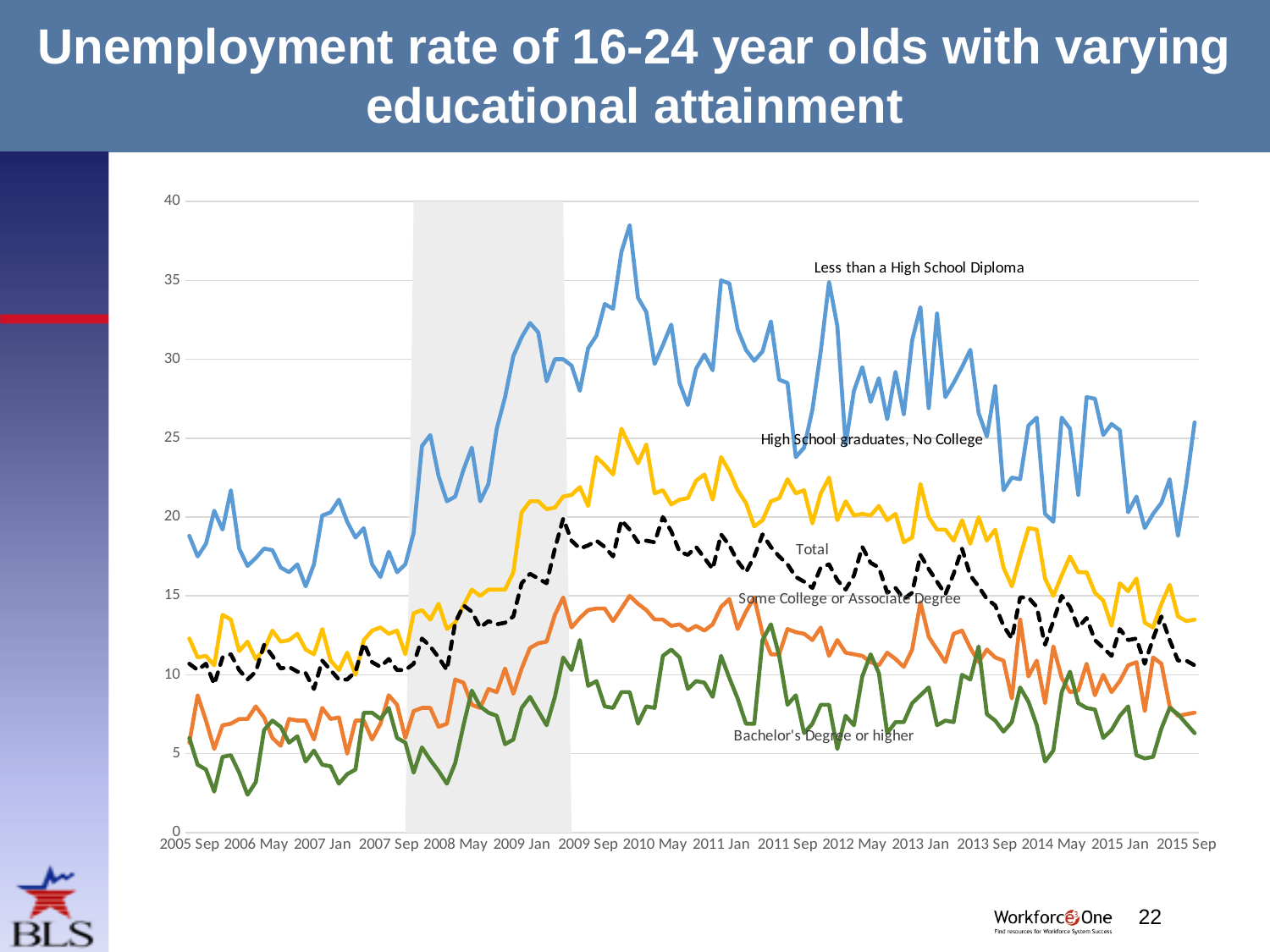
Does the Less than a High School Diploma line rise or fall between 2007 Sep and 2010 May? rise Is the value for Bachelor's Degree or higher in 2005 Sep greater or less than 10? less What kind of chart is shown on the slide? line chart Which series is higher in 2012 May: High School graduates, No College or Total? High School graduates, No College Is the value for Less than a High School Diploma in 2015 Sep greater or less than 20? greater What is the title of the slide? Unemployment rate of 16-24 year olds with varying educational attainment Which series has the highest unemployment rate throughout the period shown? Less than a High School Diploma Is the value for Some College or Associate Degree in 2015 Sep greater or less than 10? less How many series are plotted on the chart? 5 Does the Total line rise or fall between 2011 Jan and 2015 Sep? fall